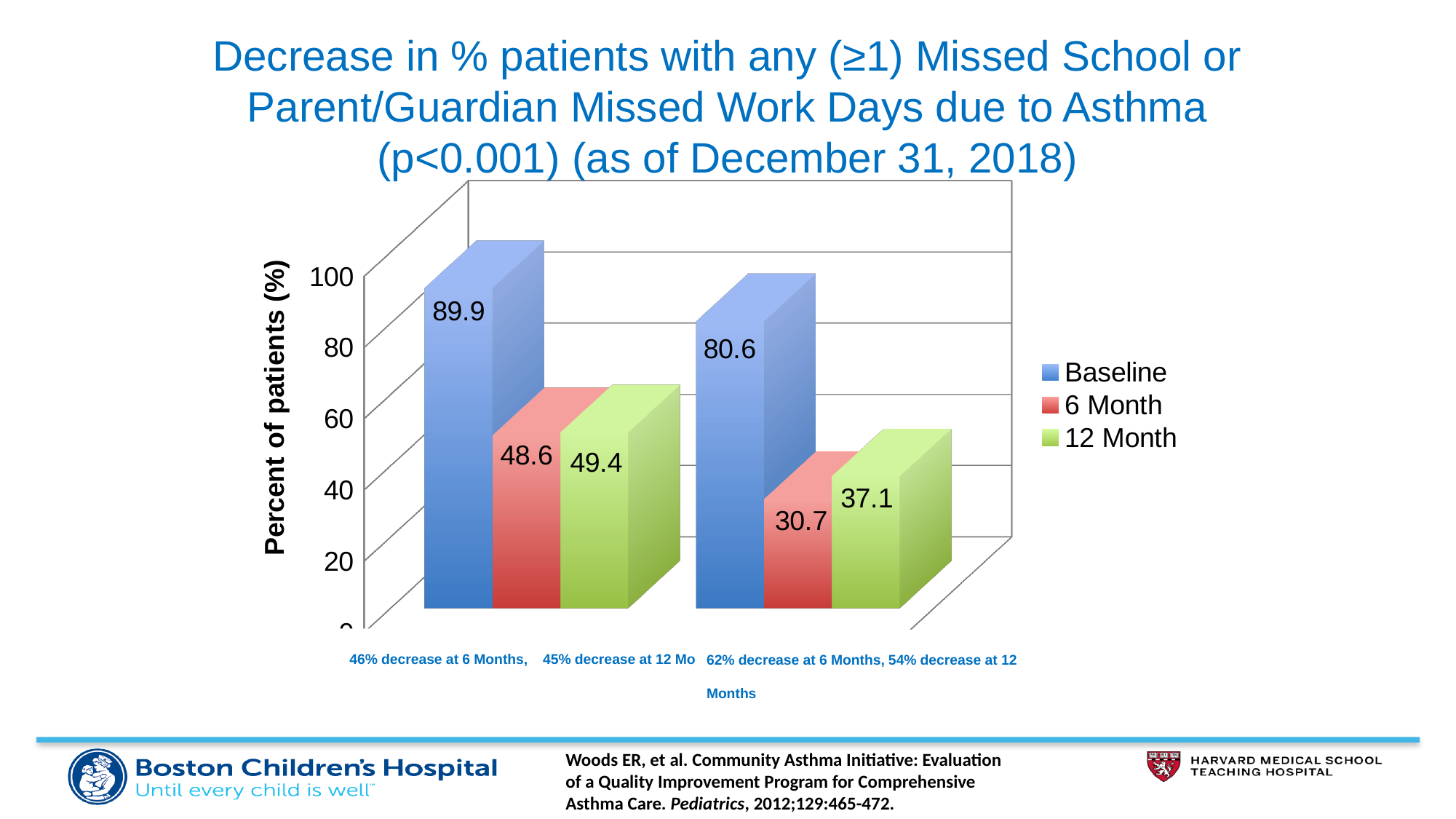
What is the Baseline value for the right group of bars? 80.6 In the right group, which is larger: the 6 Month value or the 12 Month value? 12 Month What kind of chart is shown on the slide? Bar chart In the left group, what is the difference between the Baseline and 6 Month values? 41.3 In the right group, what is the difference between the 12 Month and 6 Month values? 6.4 Which bar has the lowest value on the chart? 6 Month in the right group (30.7) What is the Baseline value for the left group of bars? 89.9 What is the 12 Month value for the left group of bars? 49.4 Which bar has the highest value on the chart? Baseline in the left group (89.9) What is the label on the vertical axis? Percent of patients (%) How many series does the legend list? 3 What is the 6 Month value for the right group of bars? 30.7